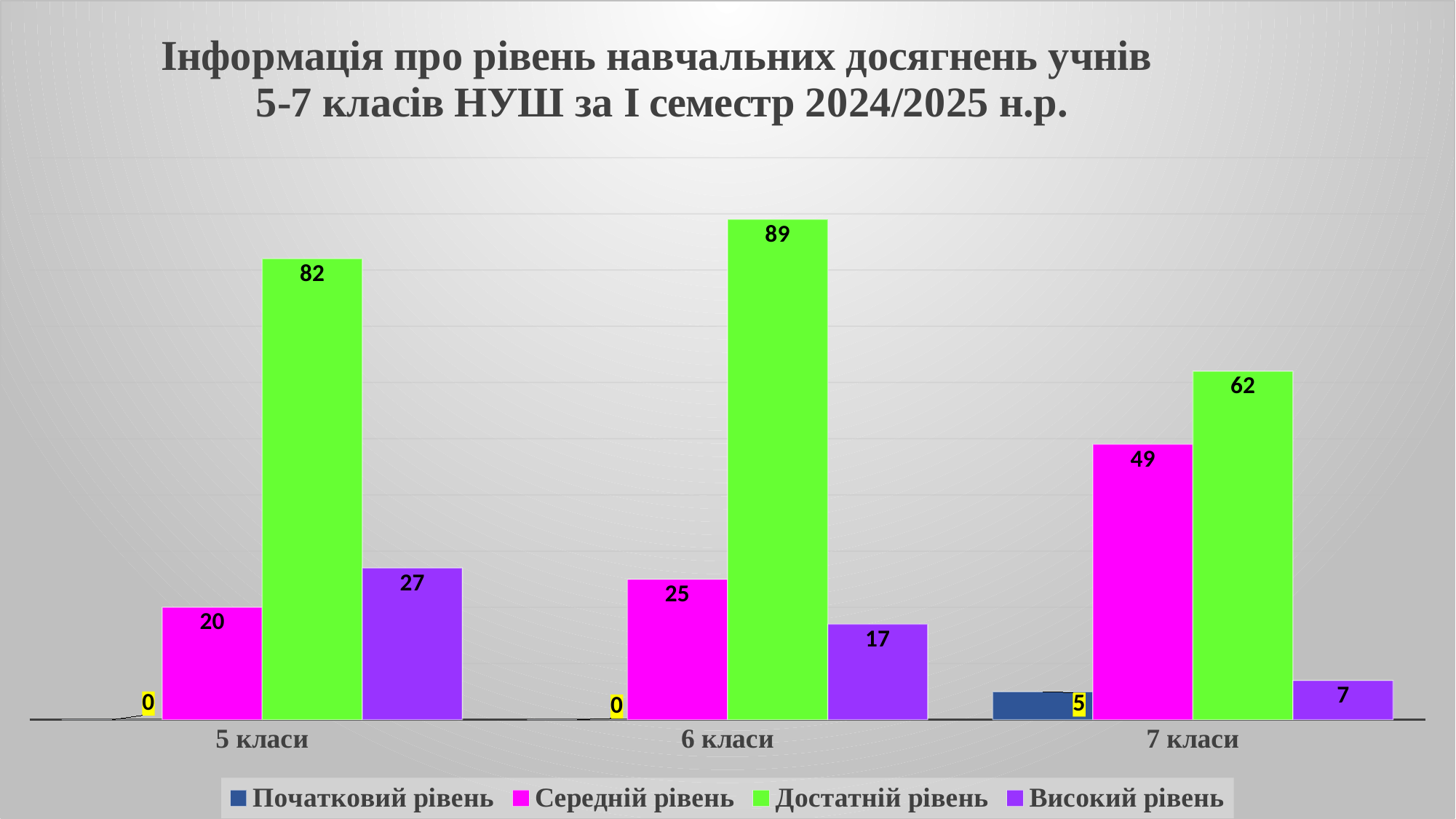
What type of chart is shown on the slide? bar chart What is the difference between Достатній рівень for 6 класи and for 7 класи? 27 How many series does the legend list? 4 Which colour represents Достатній рівень in the legend? green What is the value of Достатній рівень for 6 класи? 89 How many class groups (categories) are shown on the x axis? 3 What is the value of Початковий рівень for 7 класи? 5 Which class group has the highest value for Достатній рівень? 6 класи What is the value of Високий рівень for 5 класи? 27 Which class group has the lowest value for Високий рівень? 7 класи What is the value of Середній рівень for 7 класи? 49 Which is larger: Середній рівень for 5 класи or Середній рівень for 6 класи? Середній рівень for 6 класи